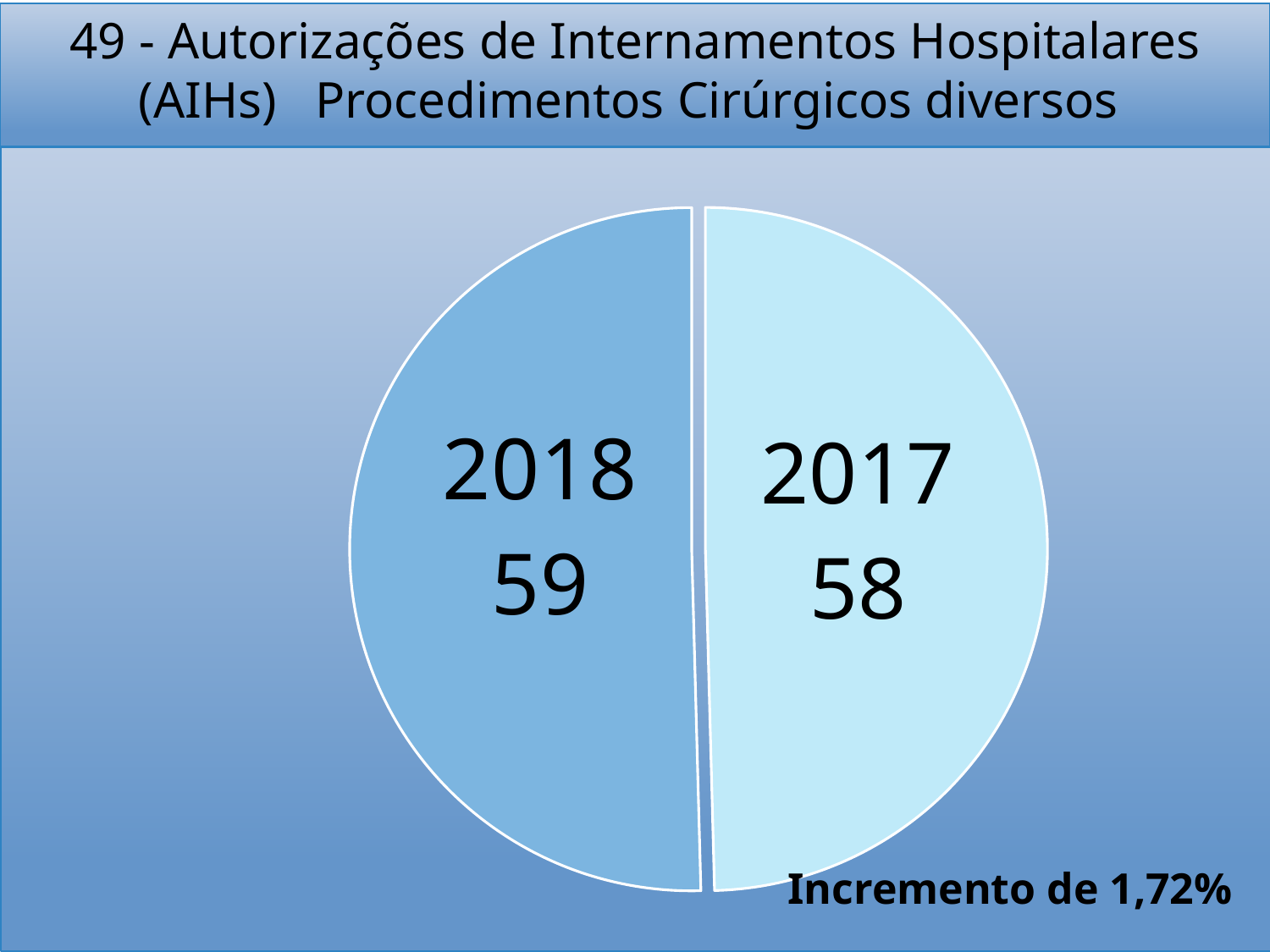
What is the difference between the values for 2018 and 2017? 1 What is the combined total of the two slices in the pie chart? 117 What is the value shown for 2018 in the pie chart? 59 How many slices does the pie chart have? 2 Which year has the smaller slice in the pie chart? 2017 Is the value for 2018 larger or smaller than the value for 2017? Larger What type of chart is shown on the slide? Pie chart What percentage increase is stated on the slide? 1,72% Which year is shown in the lighter blue slice of the pie chart? 2017 Which year has the larger slice in the pie chart? 2018 What is the value shown for 2017 in the pie chart? 58